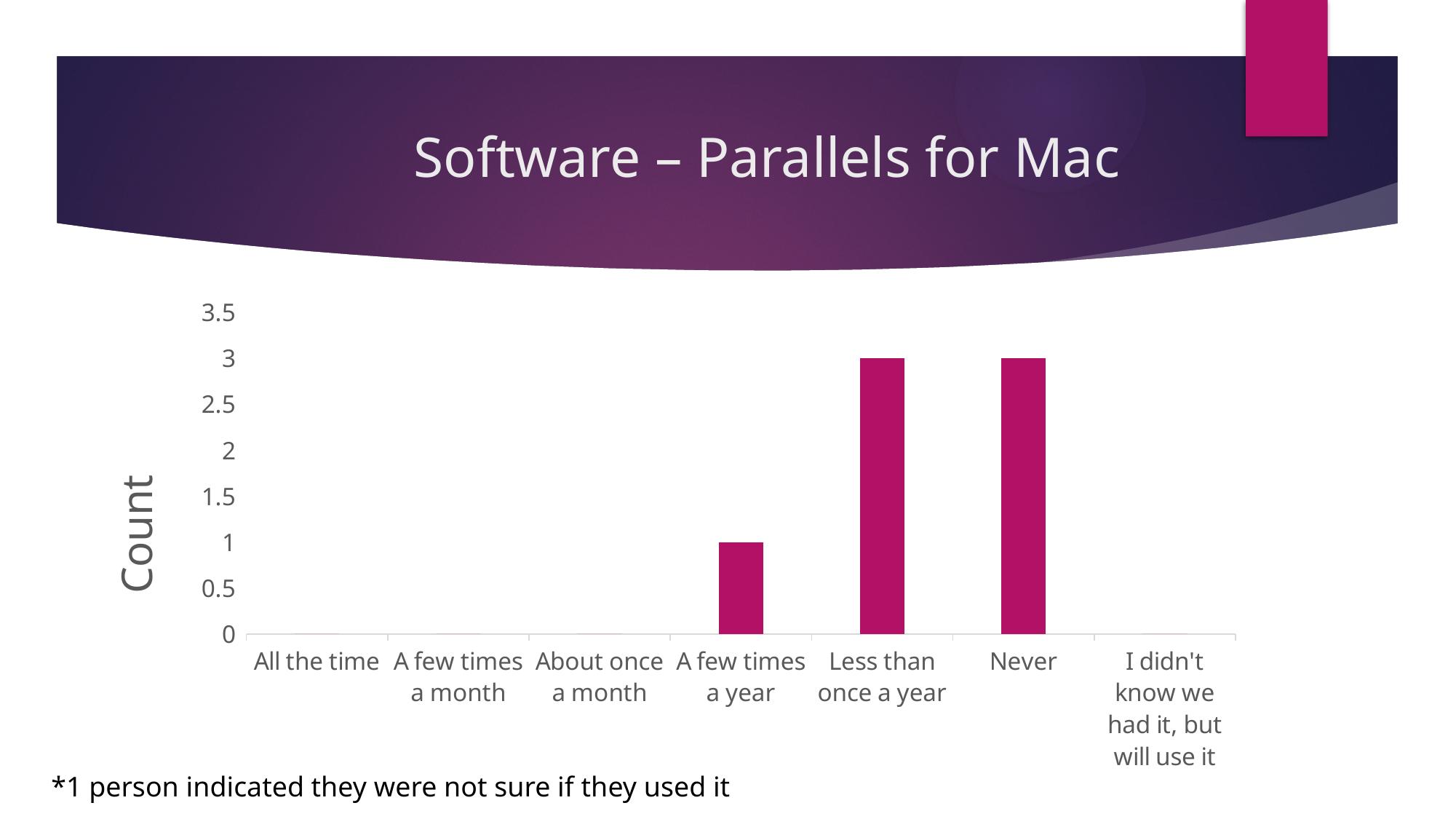
Which is larger, the count for "A few times a year" or the count for "Never"? Never What is the count for "Less than once a year"? 3 What is the count for "A few times a year"? 1 What is the difference between the count for "Never" and the count for "A few times a year"? 2 What is the label of the vertical axis? Count What is the count for "Never"? 3 Which is larger, the count for "Less than once a year" or the count for "A few times a year"? Less than once a year How many categories are shown on the x axis of the chart? 7 Is the count for "A few times a year" greater or less than 2? less Is the count for "Less than once a year" greater or less than 2? greater What is the title of the slide containing the chart? Software – Parallels for Mac What kind of chart is shown on the slide? bar chart